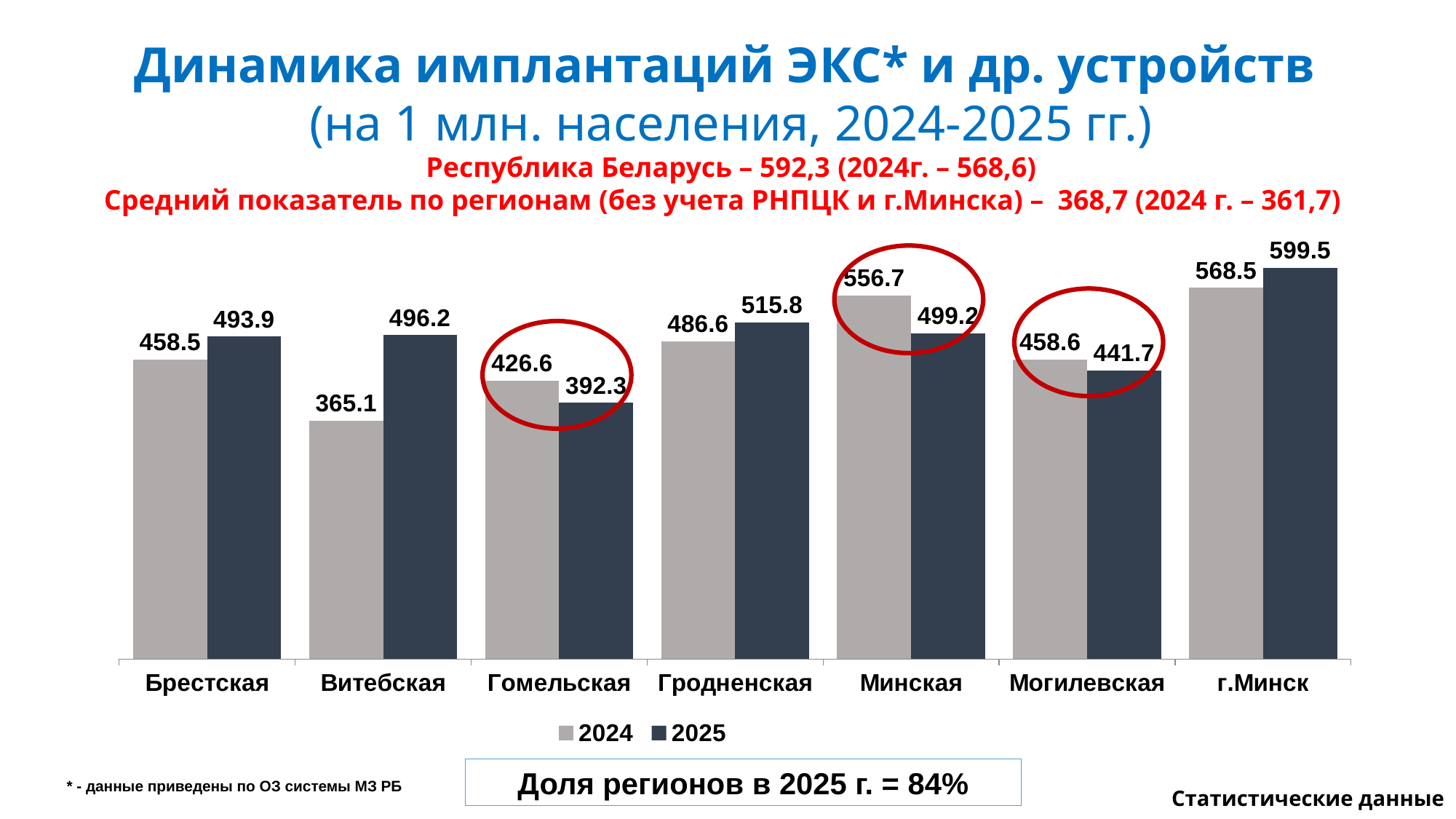
How many series does the legend list? 2 What is the value for Витебская in the 2024 series? 365.1 Which category has the lowest value in the 2024 series? Витебская What kind of chart is shown on the slide? Bar chart Which is larger for Могилевская: the 2024 value or the 2025 value? 2024 What is the value for Минская in the 2025 series? 499.2 What is the difference between the 2025 and 2024 values for Минская? 57.5 What is the difference between the 2024 and 2025 values for Гомельская? 34.3 Which category has the lowest value in the 2025 series? Гомельская Which category has the highest value in the 2025 series? г.Минск What is the value for Брестская in the 2025 series? 493.9 How many categories (regions) are shown on the x axis? 7